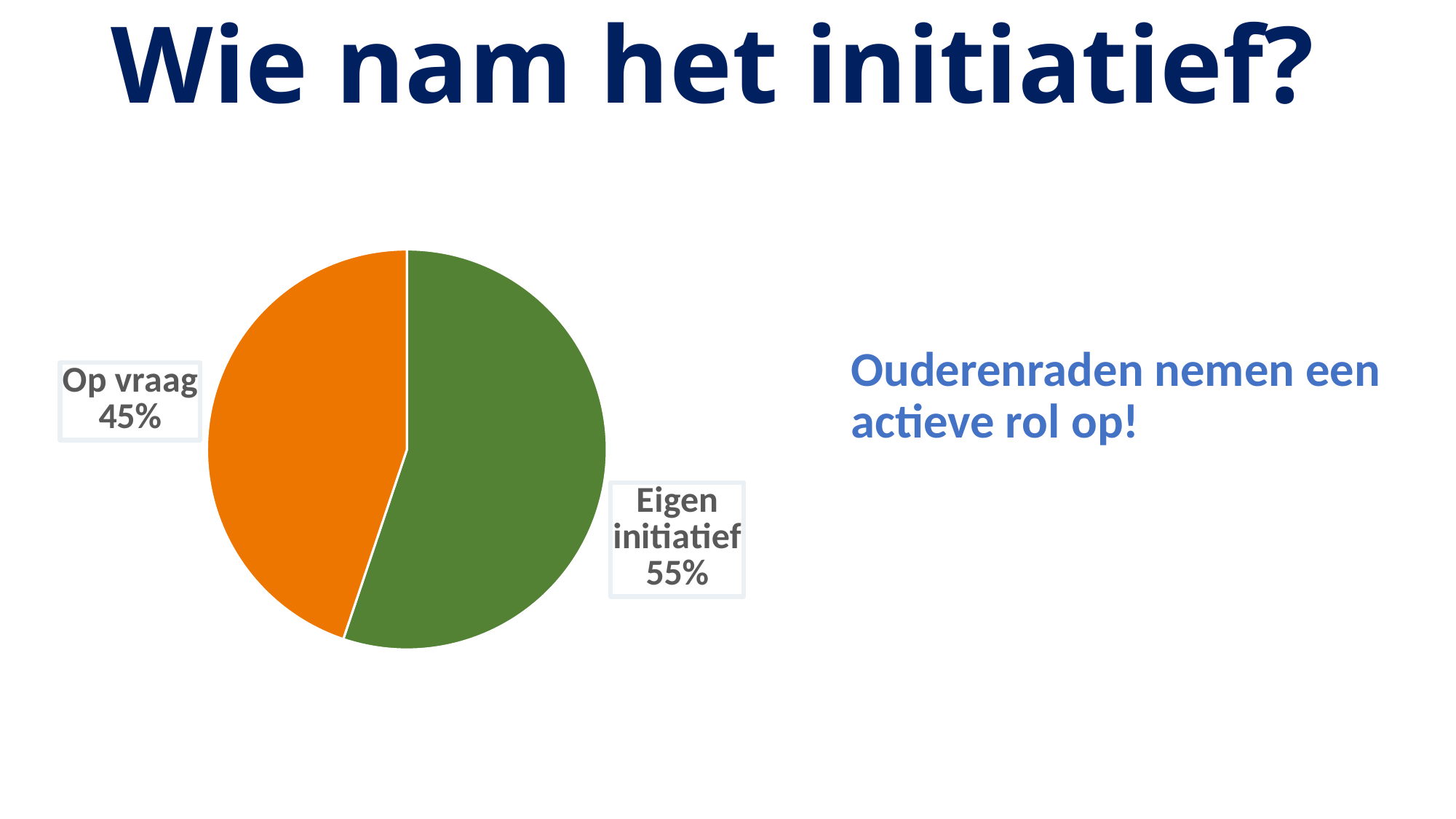
Which slice of the pie is the smallest? Op vraag How many slices does the pie chart have? 2 What share of the pie does "Op vraag" represent? 45% What colour is the "Op vraag" slice? Orange Which is larger, "Op vraag" or "Eigen initiatief"? Eigen initiatief What share of the pie does "Eigen initiatief" represent? 55% What kind of chart is shown on the slide? Pie chart Which slice of the pie is the largest? Eigen initiatief What is the total of the two slices shown in the pie chart? 100% What is the difference in percentage points between "Eigen initiatief" and "Op vraag"? 10 percentage points What colour is the "Eigen initiatief" slice? Green